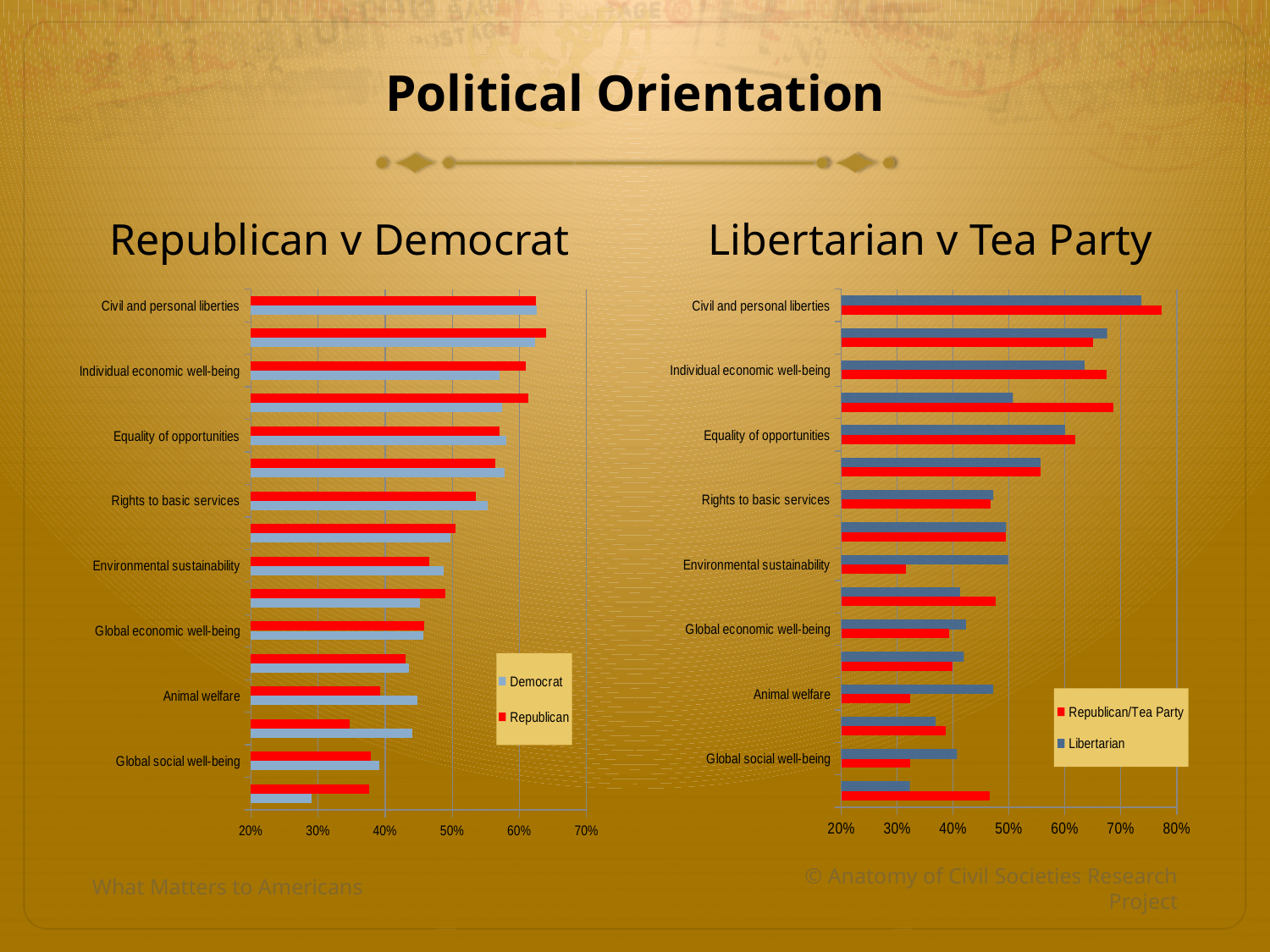
What kind of chart is the 'Libertarian v Tea Party' chart? bar chart In the 'Libertarian v Tea Party' chart, are the Republican/Tea Party values for Individual economic well-being greater or less than 60%? greater In the 'Libertarian v Tea Party' chart, are the Republican/Tea Party values for Civil and personal liberties greater or less than 60%? greater What kind of chart is the 'Republican v Democrat' chart? bar chart In the 'Libertarian v Tea Party' chart, in the upper pair of bars for Environmental sustainability, which series has the larger value, Libertarian or Republican/Tea Party? Libertarian What is the title of the slide? Political Orientation How many series does the legend of the 'Libertarian v Tea Party' chart list? 2 In the 'Republican v Democrat' chart, are the Republican values for Global social well-being greater or less than 40%? less How many series does the legend of the 'Republican v Democrat' chart list? 2 In the 'Libertarian v Tea Party' chart, which colour represents the Libertarian series? blue